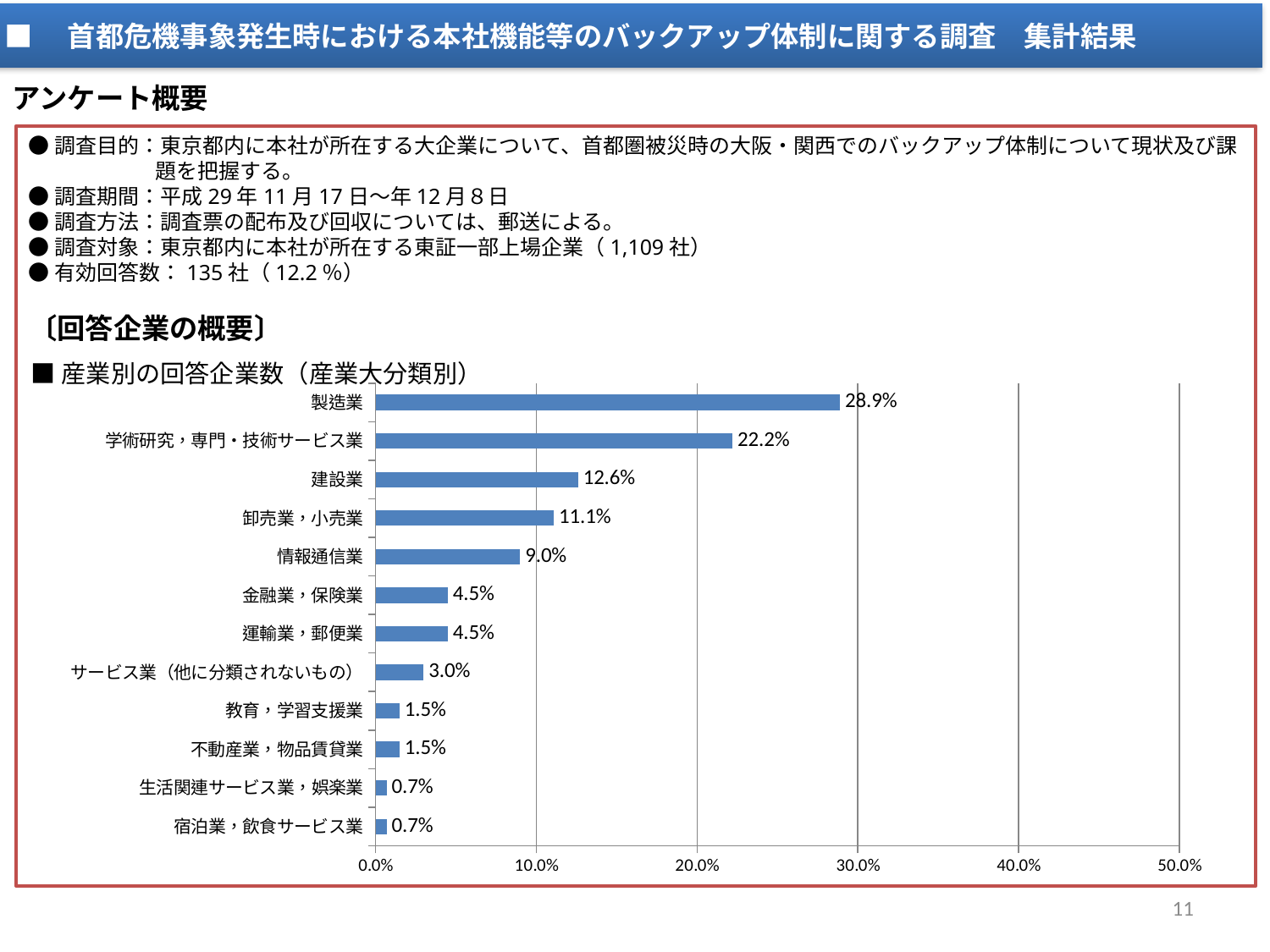
What is the difference between 建設業 and 卸売業，小売業? 1.5% What is the difference between 製造業 and 学術研究，専門・技術サービス業? 6.7% Which is larger, 卸売業，小売業 or 情報通信業? 卸売業，小売業 What is the value for 情報通信業? 9.0% What kind of chart is shown? bar chart What is the maximum value shown on the x axis? 50.0% What is the value for 製造業? 28.9% What is the value for サービス業（他に分類されないもの）? 3.0% Is the value for 学術研究，専門・技術サービス業 greater or less than 20.0%? greater Which category has the highest value? 製造業 How many categories are shown in the chart? 12 What is the value for 建設業? 12.6%